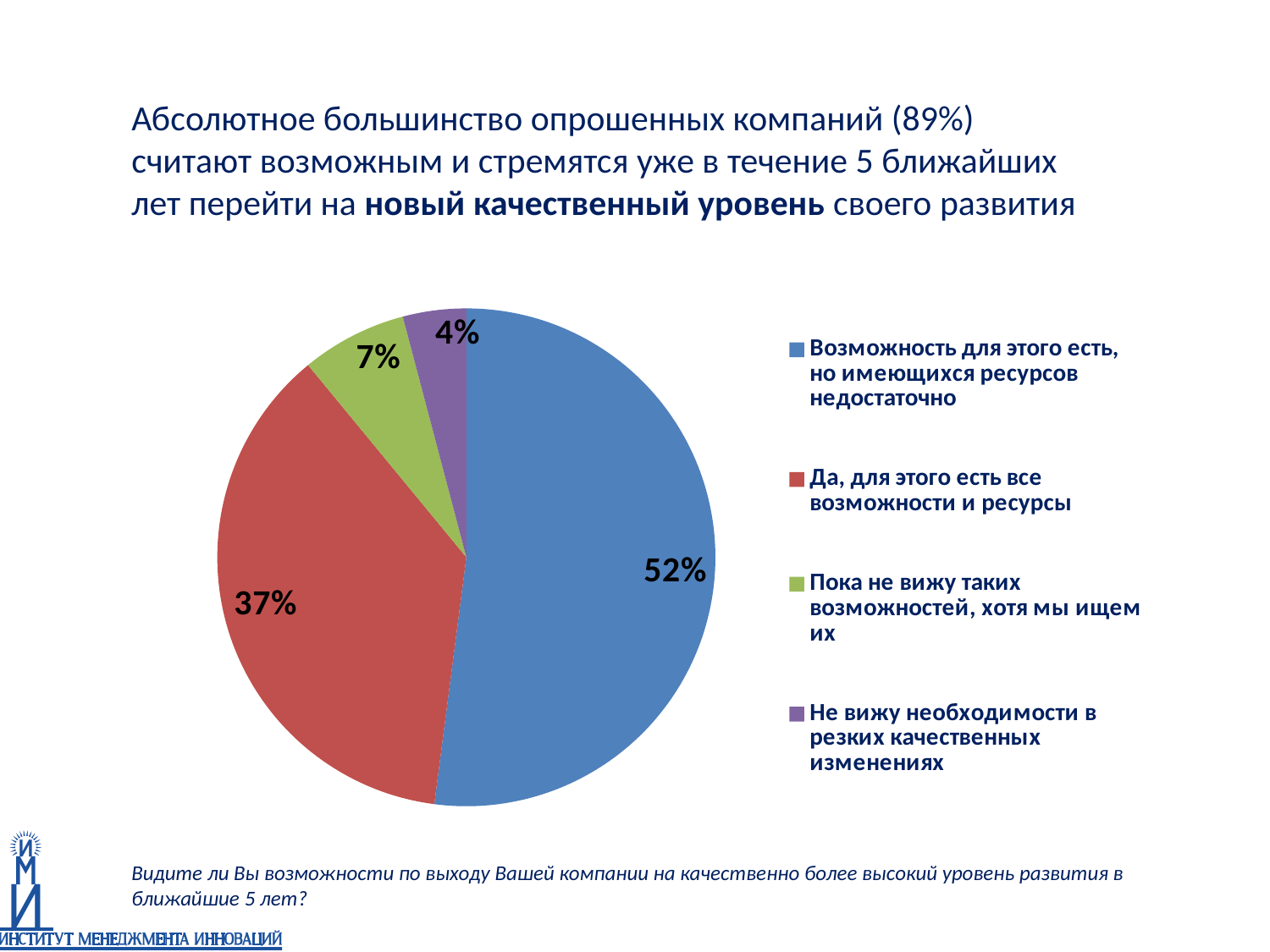
What is the combined share of the two largest slices, "Возможность для этого есть, но имеющихся ресурсов недостаточно" and "Да, для этого есть все возможности и ресурсы"? 89% What share of the pie is labelled "Пока не вижу таких возможностей, хотя мы ищем их"? 7% What colour is the slice for "Да, для этого есть все возможности и ресурсы"? red What is the difference in percentage points between the "Возможность для этого есть, но имеющихся ресурсов недостаточно" slice and the "Да, для этого есть все возможности и ресурсы" slice? 15% Which category has the largest slice of the pie? Возможность для этого есть, но имеющихся ресурсов недостаточно What share of the pie is labelled "Возможность для этого есть, но имеющихся ресурсов недостаточно"? 52% What share of the pie is labelled "Не вижу необходимости в резких качественных изменениях"? 4% Which category has the smallest slice of the pie? Не вижу необходимости в резких качественных изменениях How many categories does the pie chart have? 4 Which is larger: the "Пока не вижу таких возможностей, хотя мы ищем их" slice or the "Не вижу необходимости в резких качественных изменениях" slice? Пока не вижу таких возможностей, хотя мы ищем их What share of the pie is labelled "Да, для этого есть все возможности и ресурсы"? 37% What kind of chart is shown on the slide? pie chart